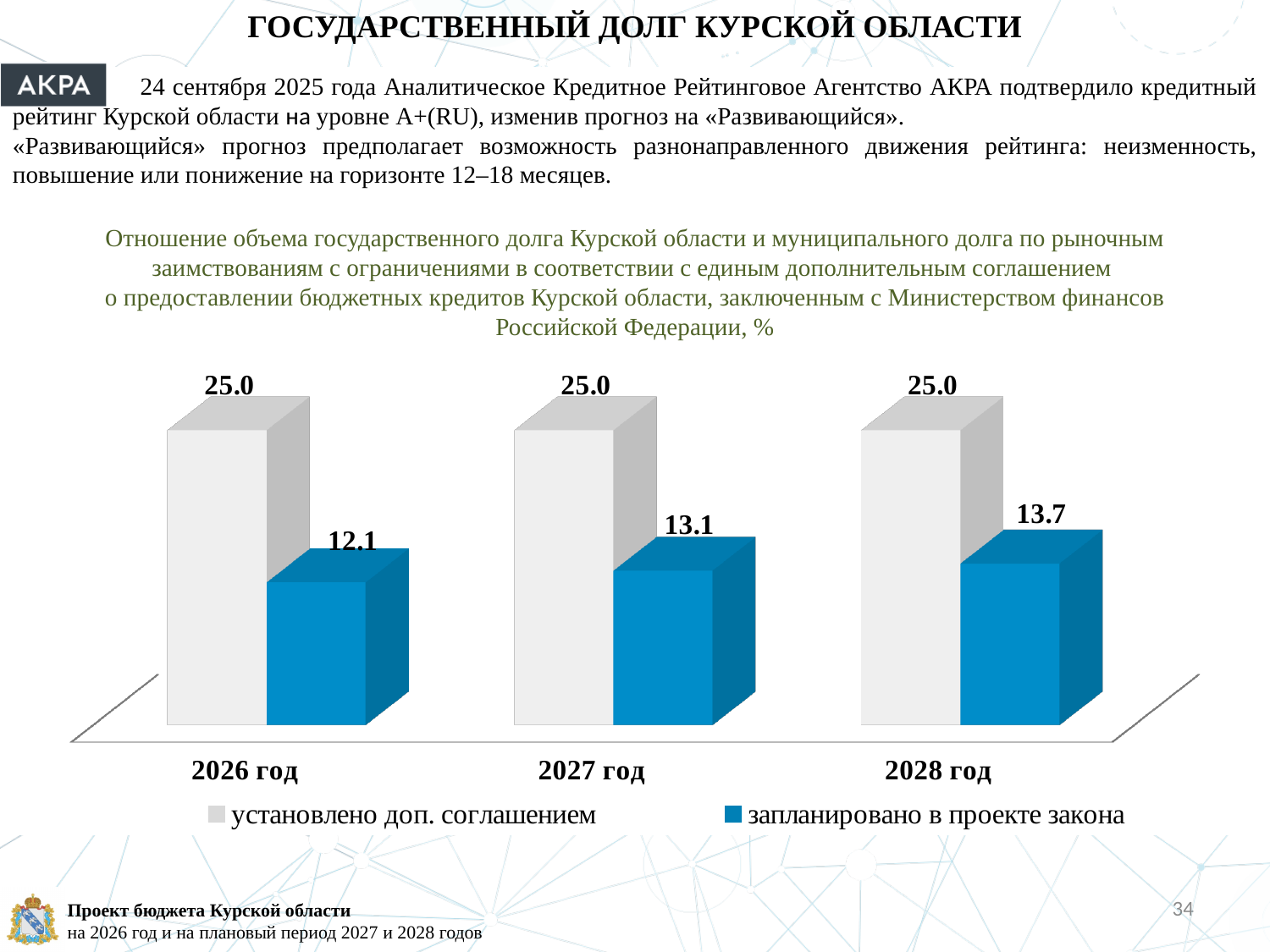
In which year is the value for "запланировано в проекте закона" the highest? 2028 год What is the difference between the "установлено доп. соглашением" and "запланировано в проекте закона" values in 2026 год? 12.9 What is the value for "запланировано в проекте закона" in 2027 год? 13.1 How many series does the chart legend list? 2 Which is larger in 2027 год: "установлено доп. соглашением" or "запланировано в проекте закона"? установлено доп. соглашением In which year is the value for "запланировано в проекте закона" the lowest? 2026 год What is the value for "установлено доп. соглашением" in 2027 год? 25.0 How many years are shown on the x axis of the chart? 3 What is the difference between the "запланировано в проекте закона" values for 2028 год and 2026 год? 1.6 What is the value for "запланировано в проекте закона" in 2026 год? 12.1 Do the values for "запланировано в проекте закона" rise or fall from 2026 год to 2028 год? rise What is the value for "запланировано в проекте закона" in 2028 год? 13.7